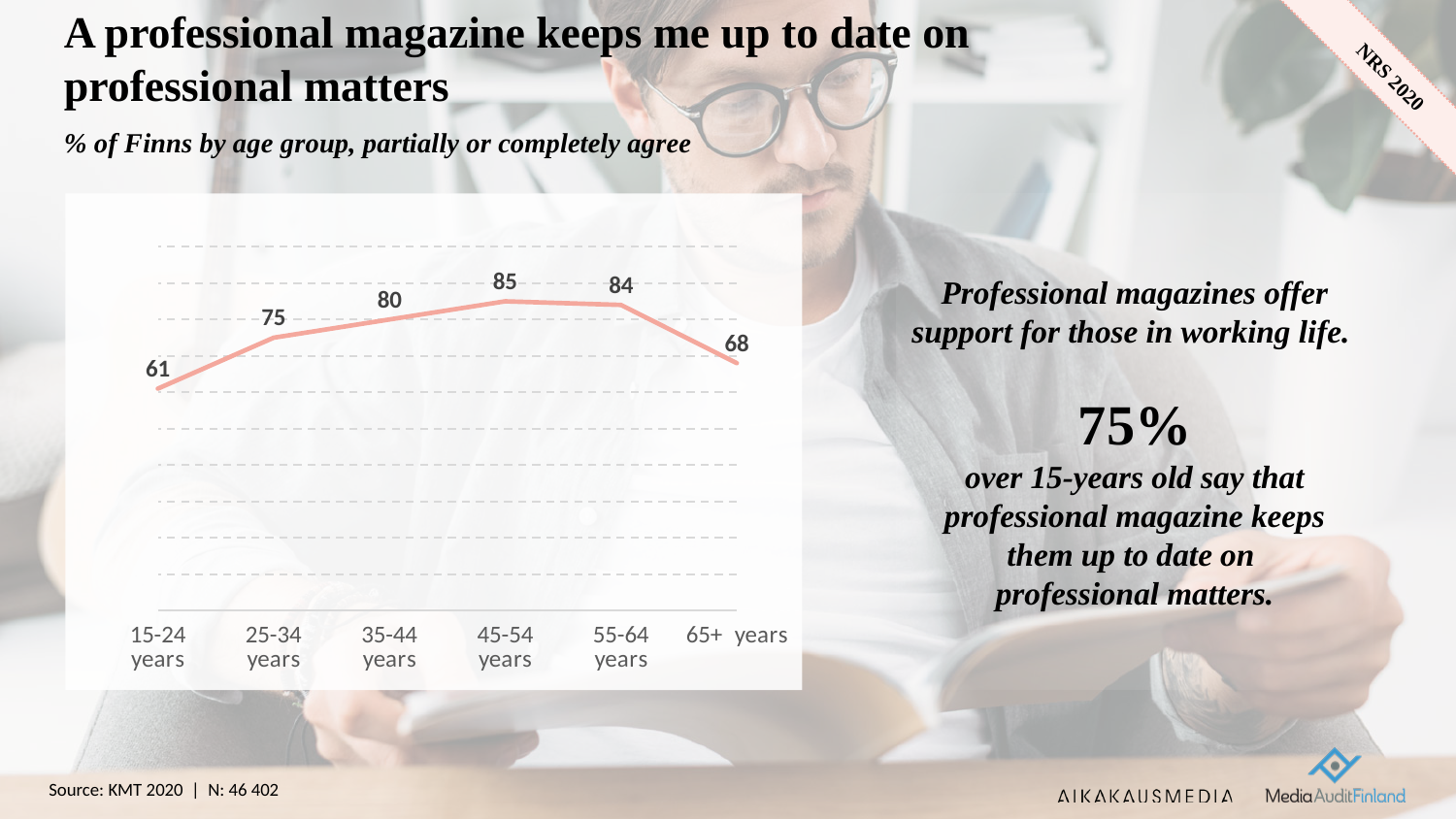
Which is larger, the value for 25-34 years or the value for 65+ years? 25-34 years (75 vs 68) How many age groups are plotted on the chart? 6 What is the value for the 45-54 years age group? 85 Which age group has the highest value? 45-54 years What is the value for the 35-44 years age group? 80 Which age group has the lowest value? 15-24 years What is the difference between the values for the 45-54 years and 15-24 years age groups? 24 What type of chart is shown on the slide? line chart Does the value rise or fall from the 55-64 years group to the 65+ years group? fall What is the value for the 65+ years age group? 68 What is the value for the 15-24 years age group? 61 What is the difference between the values for the 55-64 years and 65+ years age groups? 16